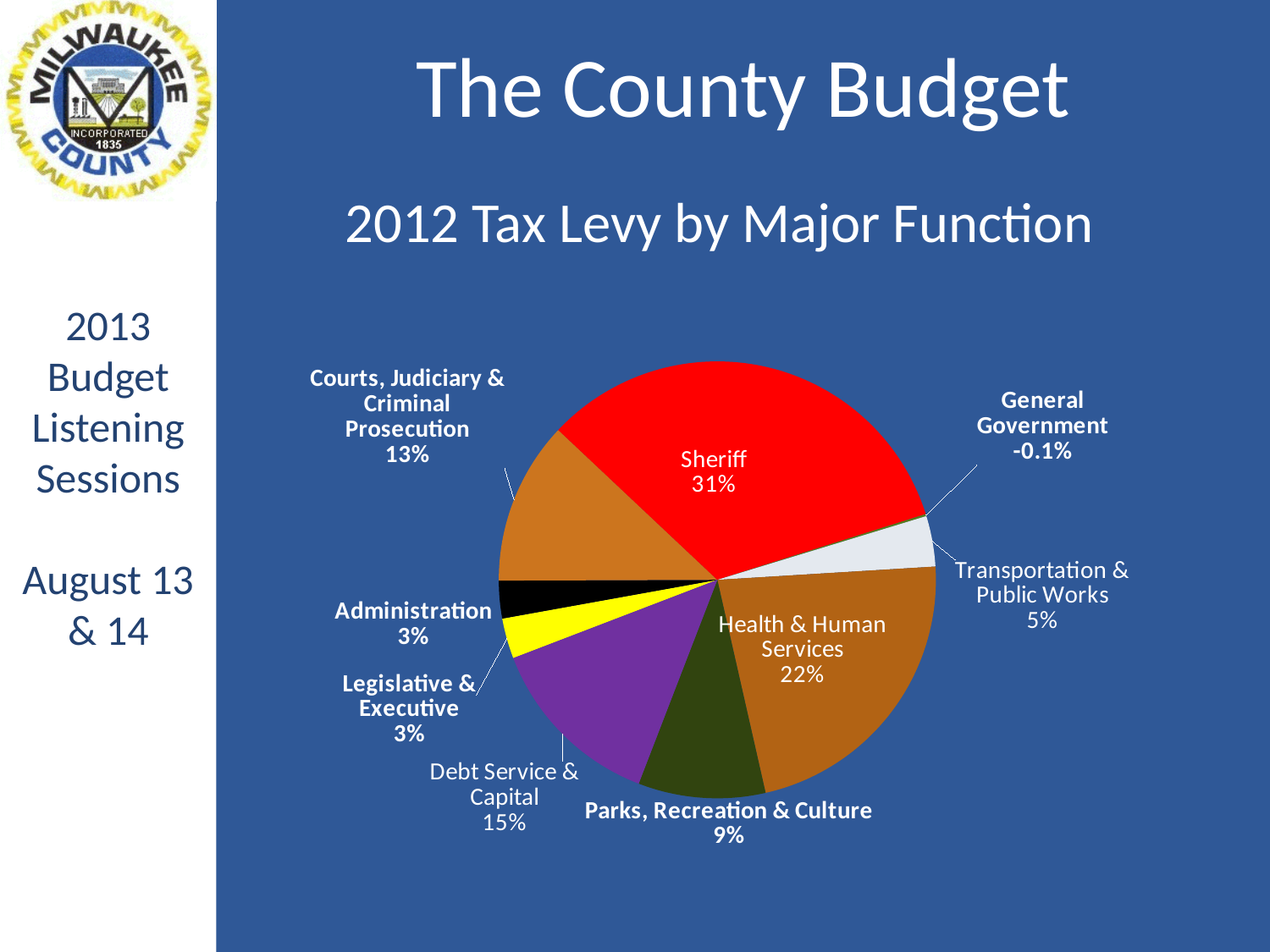
What share of the 2012 tax levy goes to Transportation & Public Works? 5% Which function has the smallest share of the 2012 tax levy? General Government Which function has the largest share of the 2012 tax levy? Sheriff Which is larger, the share for Parks, Recreation & Culture or the share for Debt Service & Capital? Debt Service & Capital What kind of chart is shown on the slide? pie chart What value is shown for General Government? -0.1% What share of the 2012 tax levy goes to Courts, Judiciary & Criminal Prosecution? 13% What share of the 2012 tax levy goes to Debt Service & Capital? 15% How many percentage points larger is the Sheriff share than the Health & Human Services share? 9 What share of the 2012 tax levy goes to Sheriff? 31% How many functions (slices) are shown in the pie chart? 9 What share of the 2012 tax levy goes to Health & Human Services? 22%